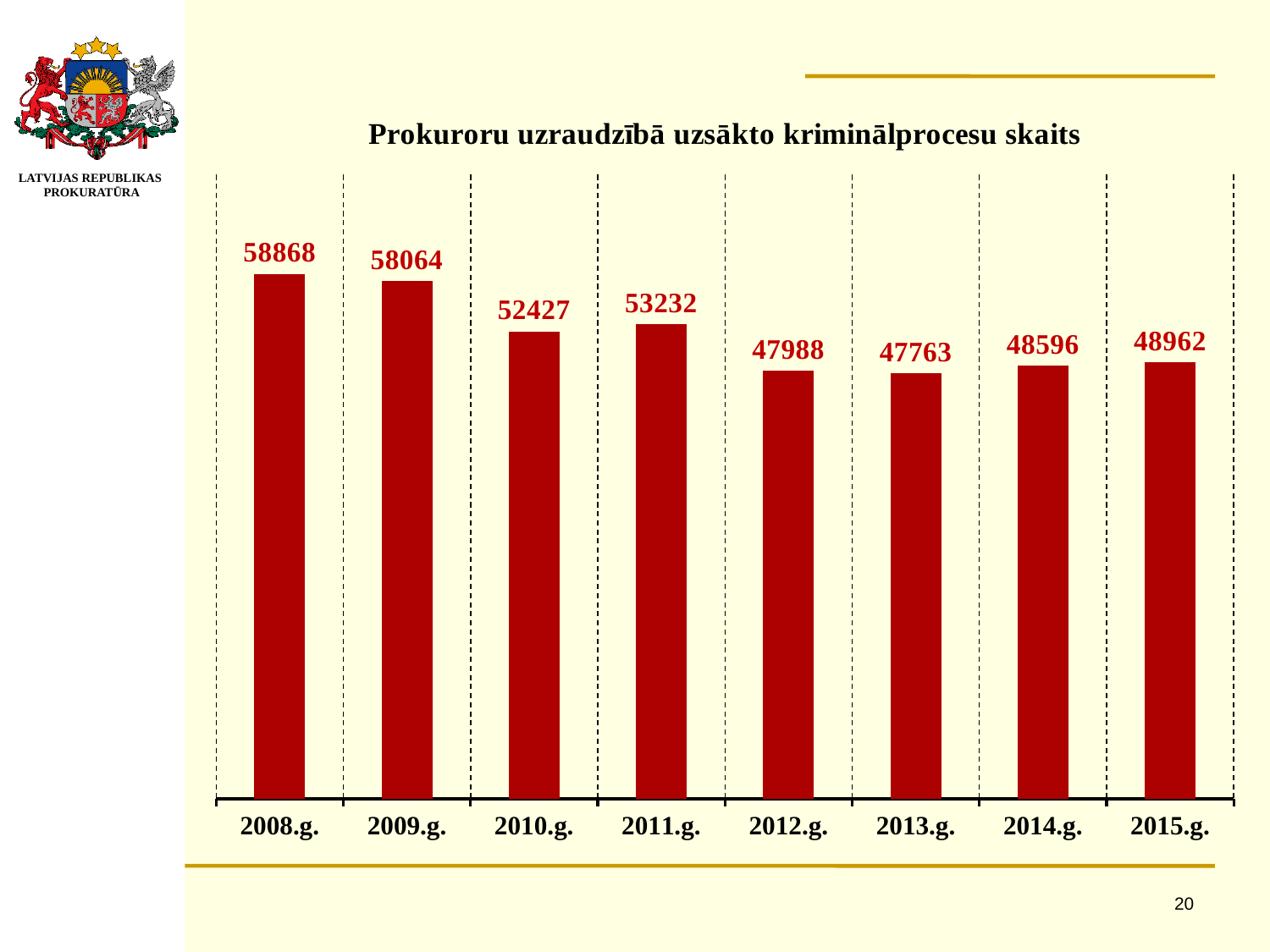
What kind of chart is this? bar chart Which is larger, the value for 2014.g. or the value for 2012.g.? 2014.g. Which year has the highest value? 2008.g. What is the value for 2015.g.? 48962 Which is larger, the value for 2010.g. or the value for 2011.g.? 2011.g. What is the difference between the values for 2008.g. and 2009.g.? 804 What is the value for 2012.g.? 47988 What is the difference between the values for 2011.g. and 2010.g.? 805 Which year has the lowest value? 2013.g. How many years are shown on the x axis? 8 What is the value for 2008.g.? 58868 What is the title of the chart? Prokuroru uzraudzībā uzsākto kriminālprocesu skaits